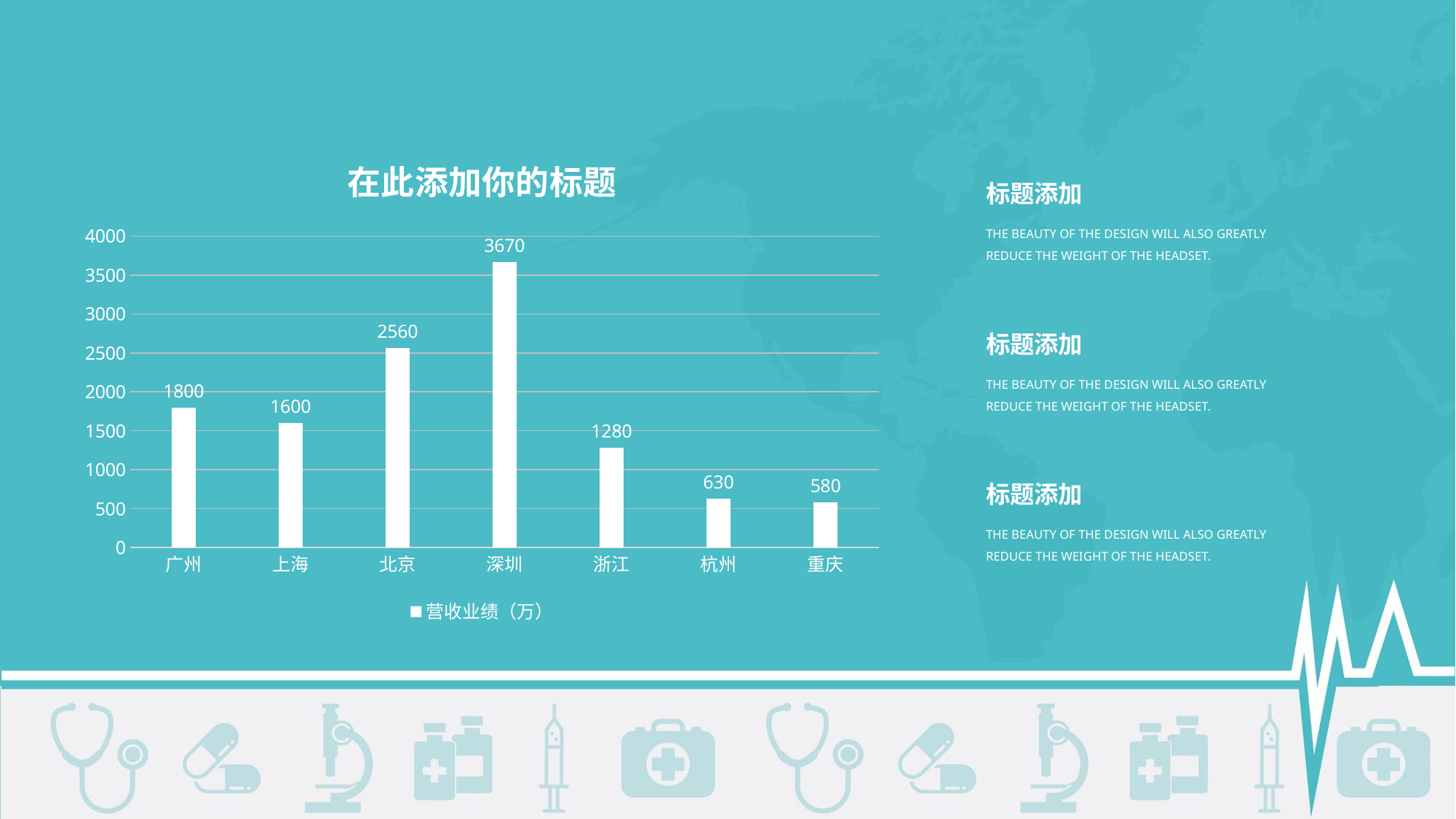
Is the value for 北京 greater or less than 2500? greater Which category has the highest value? 深圳 How many categories are shown on the x axis? 7 How many series does the legend list? 1 What is the value for 杭州? 630 What is the difference between the values for 深圳 and 浙江? 2390 Which is larger, the value for 广州 or the value for 上海? 广州 What is the difference between the values for 北京 and 上海? 960 What is the value for 广州? 1800 What is the value for 深圳? 3670 What kind of chart is shown? bar chart Which category has the lowest value? 重庆